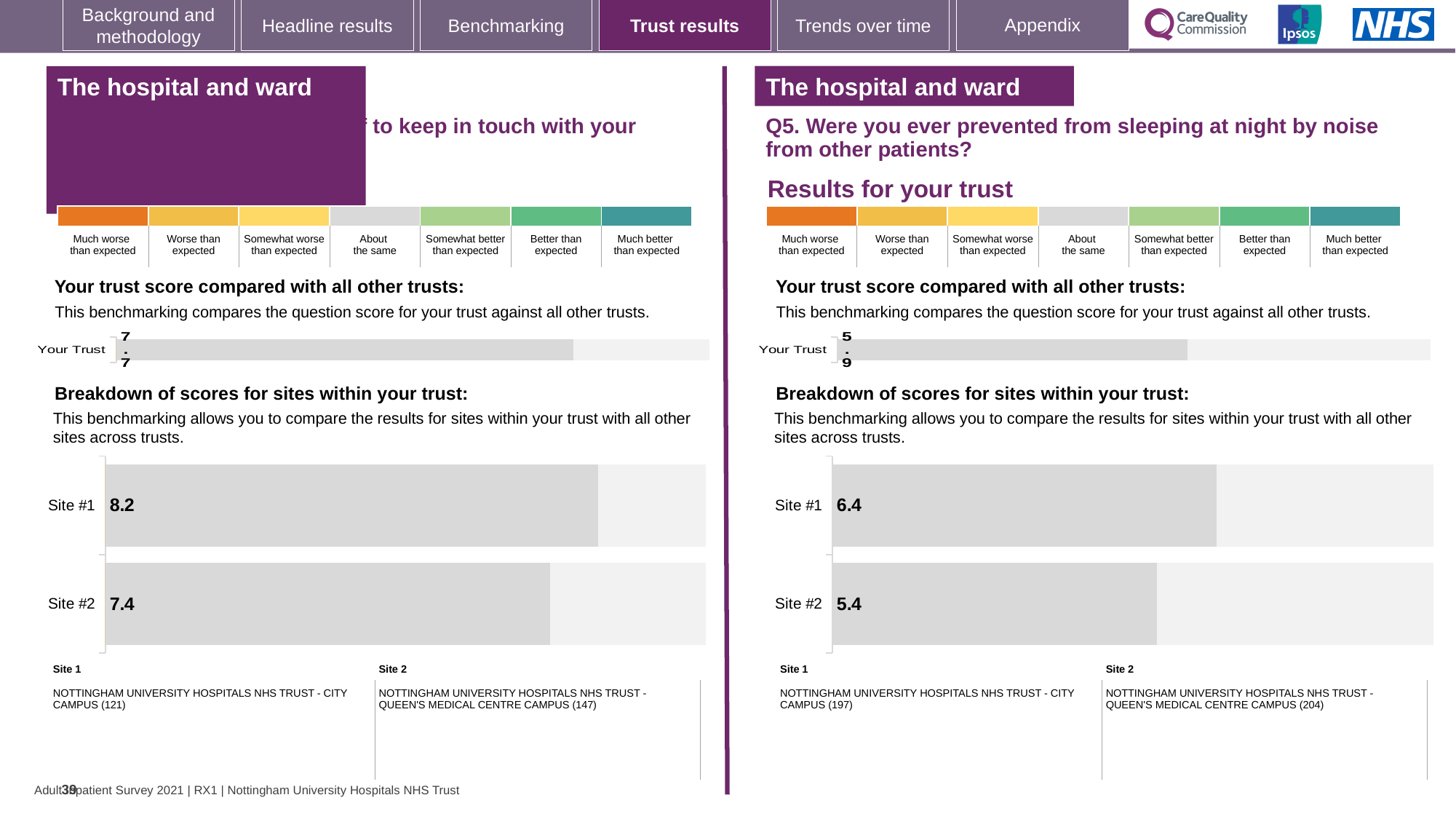
On the right-hand panel (Q5), what is the 'Your Trust' score shown in the trust benchmarking bar? 5.9 On the left-hand panel, what is the 'Your Trust' score shown in the trust benchmarking bar? 7.7 On the right-hand chart (Q5, noise from other patients), what is the score for Site #1? 6.4 On the right-hand chart (Q5), which site has the higher score, Site #1 or Site #2? Site #1 On the left-hand chart, what is the score for Site #1? 8.2 On the right-hand chart (Q5, noise from other patients), what is the score for Site #2? 5.4 How many sites are shown in the site breakdown chart on the right-hand panel (Q5)? 2 On the left-hand chart, what is the score for Site #2? 7.4 What type of chart is used for the breakdown of scores for sites on the right-hand panel (Q5)? Bar chart On the left-hand chart, what is the difference between the Site #1 and Site #2 scores? 0.8 On the left-hand chart, which site has the lowest score? Site #2 On the right-hand chart (Q5), what is the difference between the Site #1 and Site #2 scores? 1.0